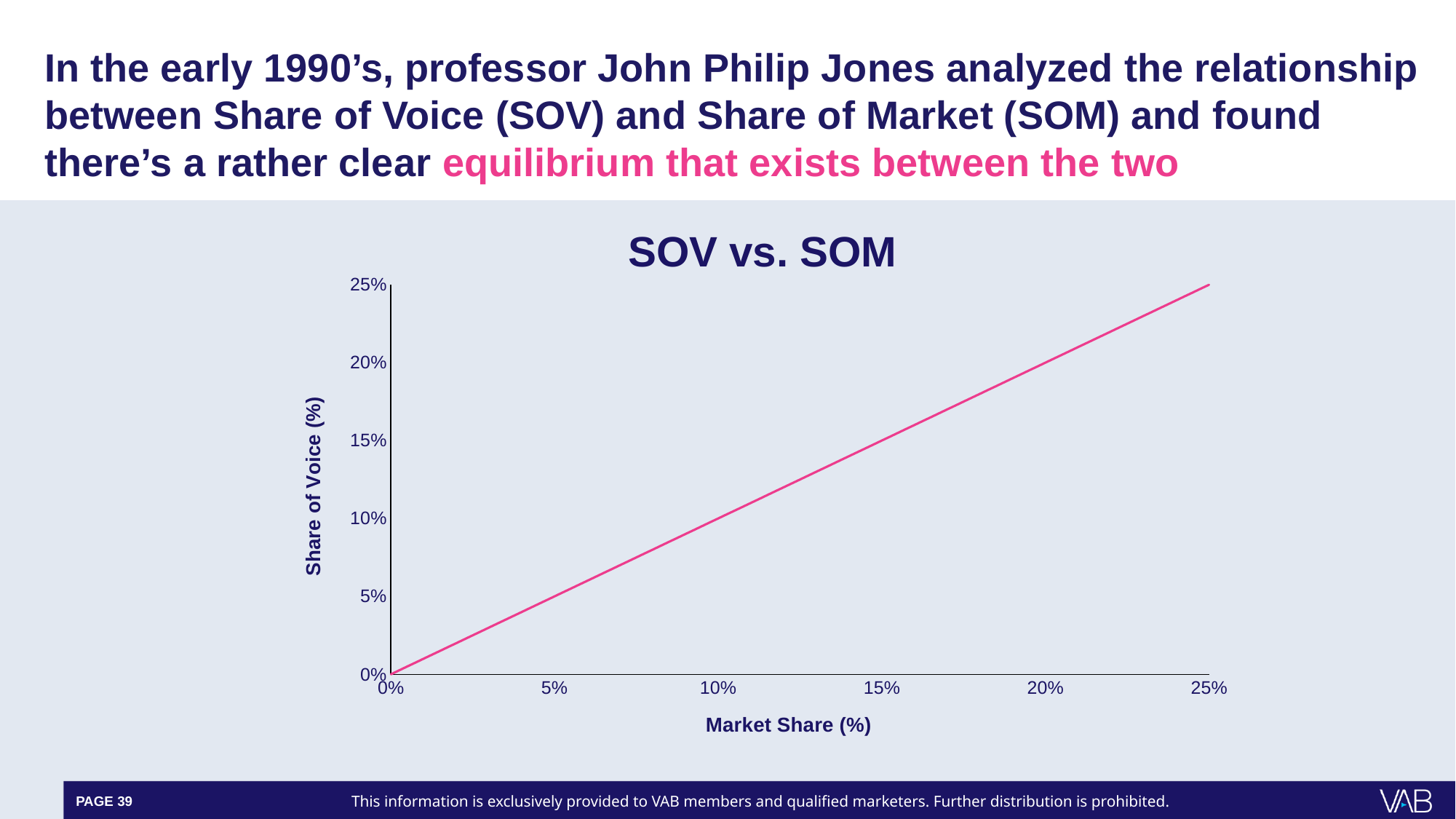
What is the Share of Voice value where the line ends at 25% Market Share? 25% What is the label of the x axis? Market Share (%) Is the Share of Voice at 20% Market Share greater or less than 15%? greater What is the difference between the Share of Voice at 25% Market Share and at 0% Market Share? 25% Does the Share of Voice rise or fall as Market Share increases along the x axis? rise Is the Share of Voice at 5% Market Share greater or less than 10%? less What is the highest Share of Voice value shown on the y axis? 25% Which is larger: the Share of Voice at 15% Market Share or at 5% Market Share? 15% Market Share What is the title of the chart? SOV vs. SOM What is the Share of Voice value at 10% Market Share? 10% What type of chart is shown on the slide? line chart What is the Share of Voice value where the line starts at 0% Market Share? 0%